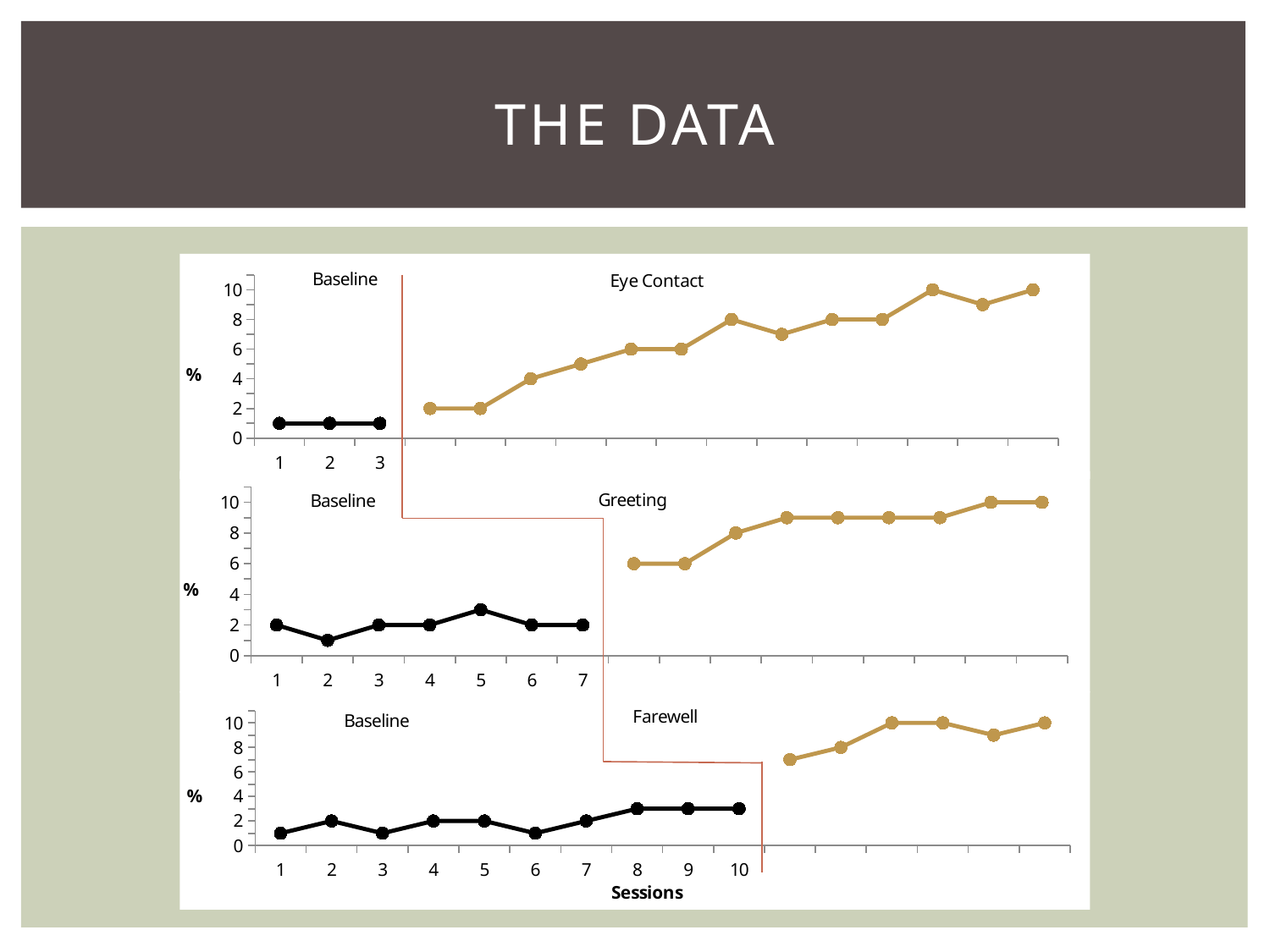
In the Eye Contact chart, do the values in the intervention phase generally rise or fall across sessions? rise In the Greeting chart, which baseline session has the highest value? 5 What is the label on the x axis at the bottom of the slide? Sessions In the Farewell chart, which is larger, the value for session 8 or the value for session 1? session 8 In the Farewell chart, is the value of the first intervention point greater or less than 6? greater In the Greeting chart, which baseline session has the lowest value? 2 In the Greeting chart, what is the value for session 1? 2 In the Farewell chart, what is the value for session 2? 2 In the Farewell chart, how many baseline sessions are plotted? 10 What kind of chart is used for the Eye Contact, Greeting and Farewell data on this slide? line chart In the Eye Contact chart, how many baseline sessions are plotted? 3 How many charts are shown on the slide? 3